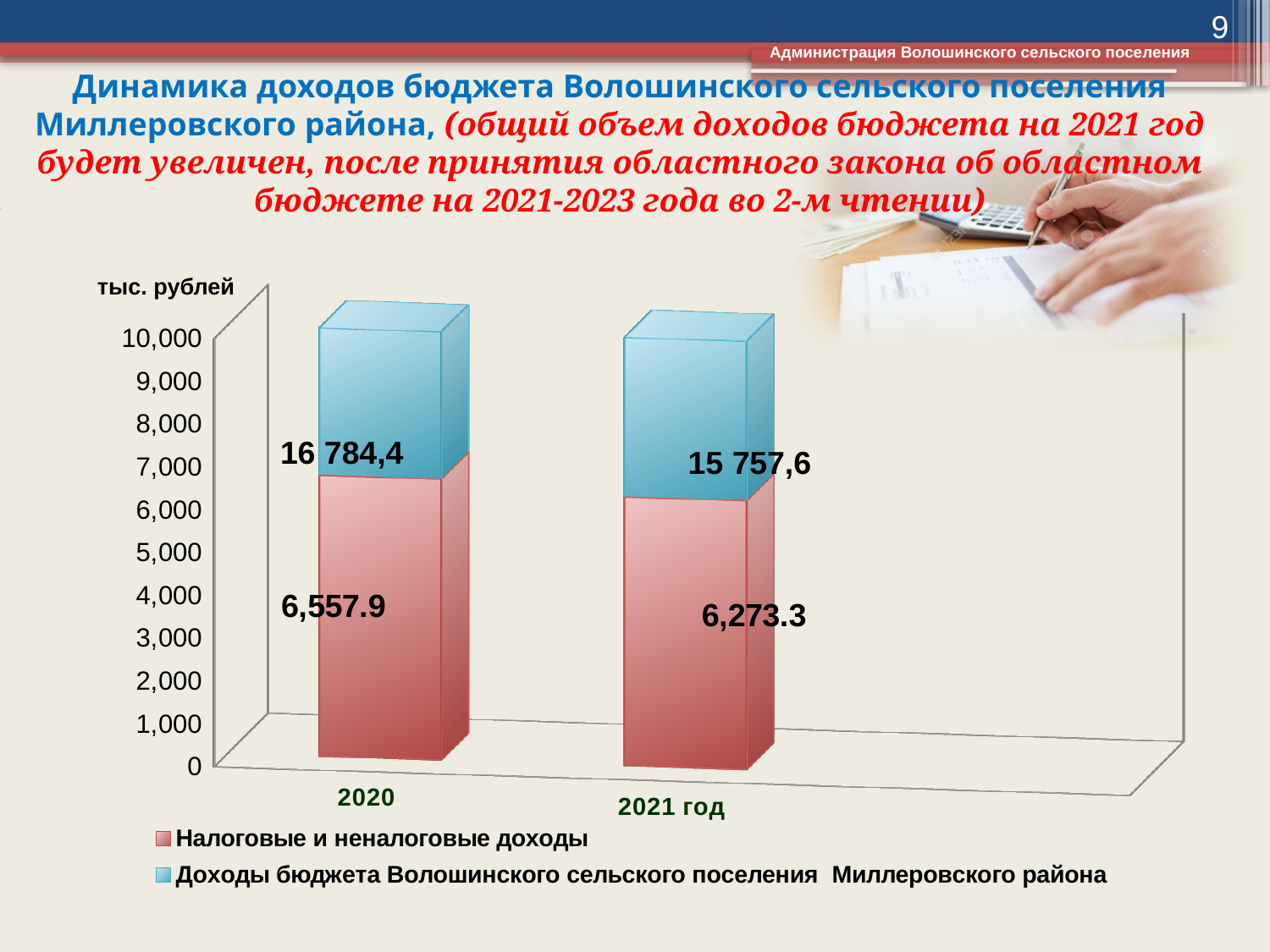
What value is labelled for Налоговые и неналоговые доходы in 2020? 6,557.9 Does the labelled value for Налоговые и неналоговые доходы fall or rise from 2020 to 2021 год? fall By how much does the labelled value for Налоговые и неналоговые доходы in 2020 exceed that in 2021 год? 284.6 How many categories (years) are shown on the x axis of the chart? 2 What value is labelled for Налоговые и неналоговые доходы in 2021 год? 6,273.3 What value is labelled on the blue segment (Доходы бюджета Волошинского сельского поселения Миллеровского района) for 2020? 16 784,4 What kind of chart is shown on the slide? stacked bar chart Which year has the higher labelled value for Налоговые и неналоговые доходы, 2020 or 2021 год? 2020 What value is labelled on the blue segment (Доходы бюджета Волошинского сельского поселения Миллеровского района) for 2021 год? 15 757,6 Is the value for Налоговые и неналоговые доходы in 2020 greater or less than 6,000? greater How many series does the chart legend list? 2 What unit is indicated above the vertical axis of the chart? тыс. рублей